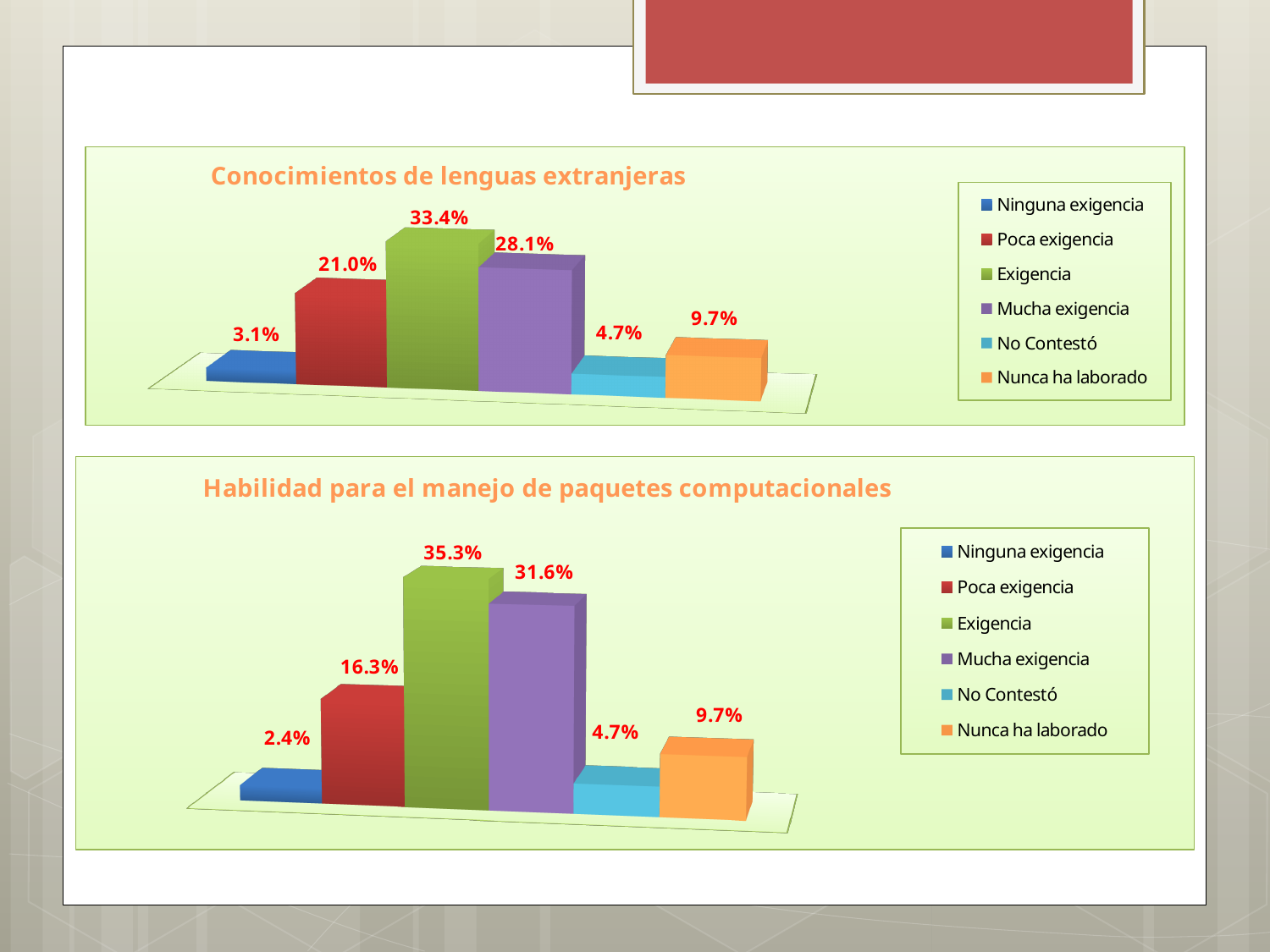
In the 'Habilidad para el manejo de paquetes computacionales' chart, which category has the lowest value? Ninguna exigencia In the 'Habilidad para el manejo de paquetes computacionales' chart, what is the difference between Poca exigencia and No Contestó? 11.6% In the 'Conocimientos de lenguas extranjeras' chart, how many categories does the legend list? 6 In the 'Conocimientos de lenguas extranjeras' chart, which category has the lowest value? Ninguna exigencia In the 'Conocimientos de lenguas extranjeras' chart, which category has the highest value? Exigencia In the 'Habilidad para el manejo de paquetes computacionales' chart, what is the value for Nunca ha laborado? 9.7% What type of chart is the 'Habilidad para el manejo de paquetes computacionales' chart? Bar chart In the 'Conocimientos de lenguas extranjeras' chart, what is the value for Ninguna exigencia? 3.1% In the 'Conocimientos de lenguas extranjeras' chart, what is the value for Exigencia? 33.4% In the 'Habilidad para el manejo de paquetes computacionales' chart, what is the value for Poca exigencia? 16.3% In the 'Habilidad para el manejo de paquetes computacionales' chart, which is larger, Exigencia or Mucha exigencia? Exigencia In the 'Conocimientos de lenguas extranjeras' chart, what is the difference between Exigencia and Mucha exigencia? 5.3%